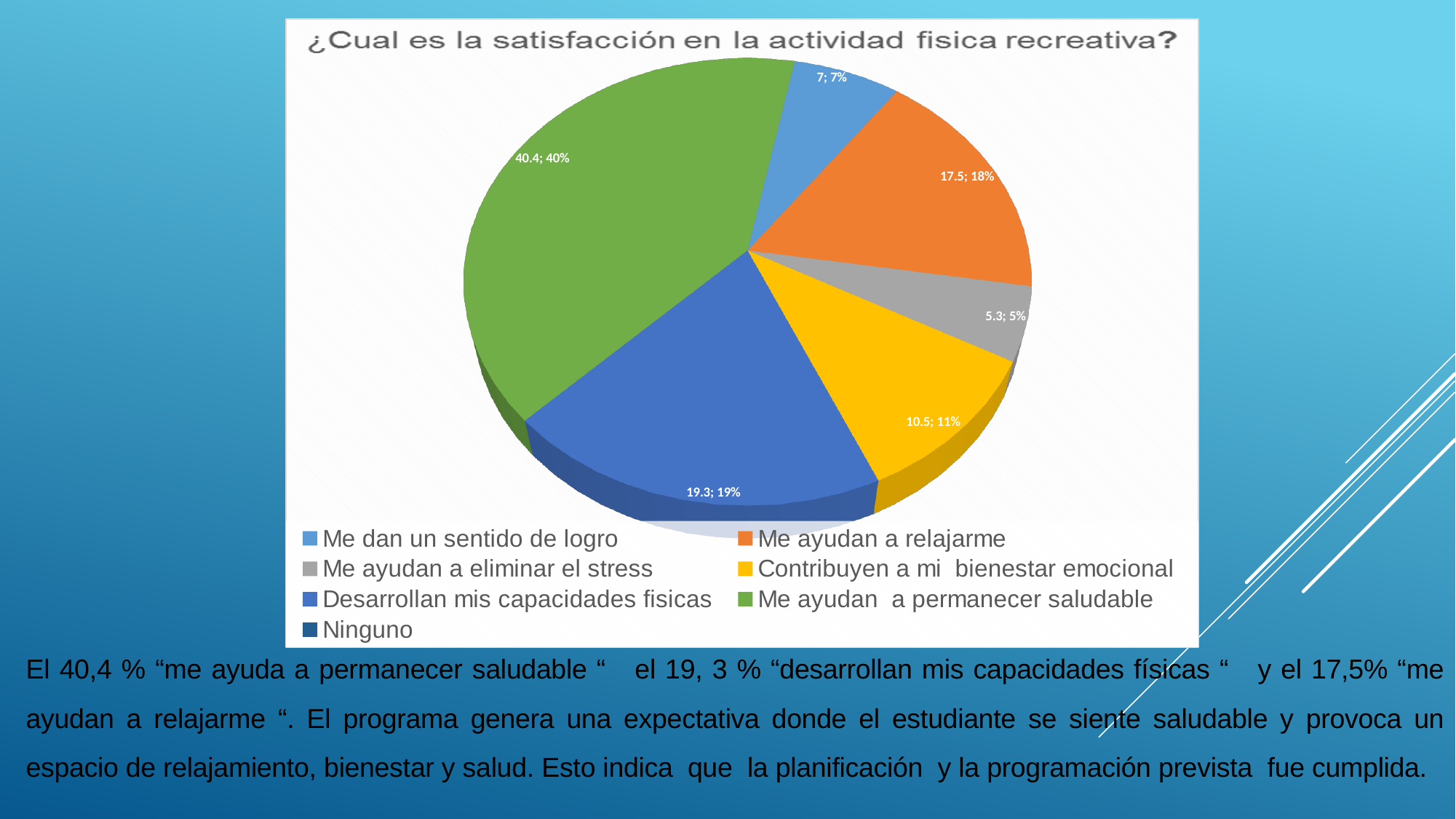
How many entries does the chart legend list? 7 What percentage share is shown for "Me ayudan a eliminar el stress"? 5% What is the difference between the values for "Me ayudan a permanecer saludable" and "Desarrollan mis capacidades fisicas"? 21.1 What kind of chart is shown on the slide? pie chart Which is larger, the value for "Me dan un sentido de logro" or the value for "Me ayudan a relajarme"? Me ayudan a relajarme What value is shown for "Me ayudan a relajarme"? 17.5 What value is shown for the slice "Me ayudan a permanecer saludable"? 40.4 Which visible slice of the pie is the smallest? Me ayudan a eliminar el stress What is the title of the chart? ¿Cual es la satisfacción en la actividad fisica recreativa? Which category has the largest slice of the pie? Me ayudan a permanecer saludable What value is shown for "Contribuyen a mi bienestar emocional"? 10.5 What percentage share is shown for "Desarrollan mis capacidades fisicas"? 19%